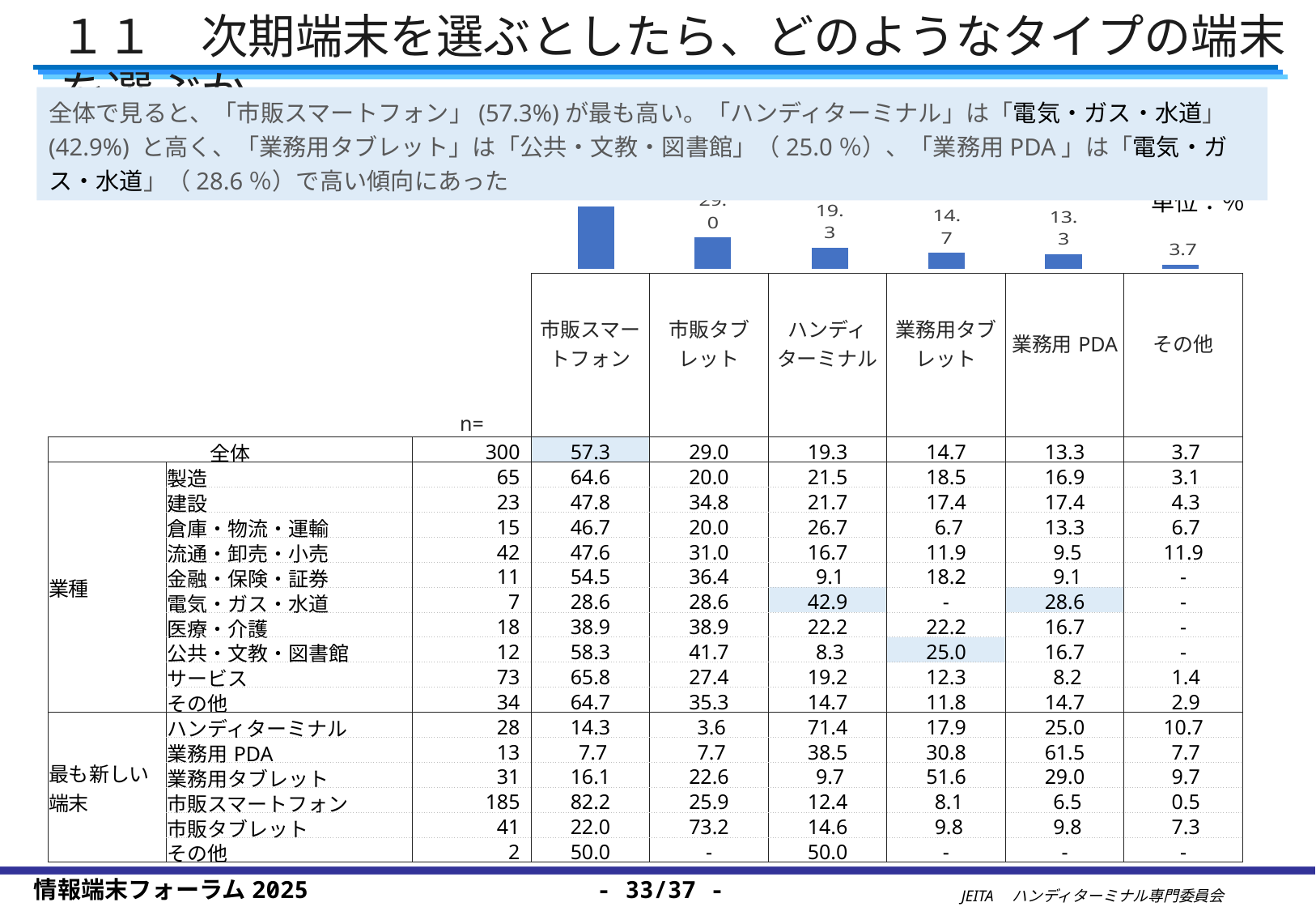
What kind of chart is shown above the table on the slide? bar chart In the chart above the table, what is the value for 業務用PDA? 13.3 In the chart above the table, which category has the lowest bar? その他 In the chart above the table, which category has the highest bar? 市販スマートフォン In the chart above the table, what is the value for 業務用タブレット? 14.7 How many bars does the chart above the table have? 6 In the chart above the table, what is the difference between the values for 市販タブレット and ハンディターミナル? 9.7 In the chart above the table, what is the value for ハンディターミナル? 19.3 In the chart above the table, what is the value for その他? 3.7 In the chart above the table, do the bar values rise or fall from left to right? fall In the chart above the table, what is the value for 市販タブレット? 29.0 In the chart above the table, which is larger, the value for 業務用タブレット or the value for 業務用PDA? 業務用タブレット